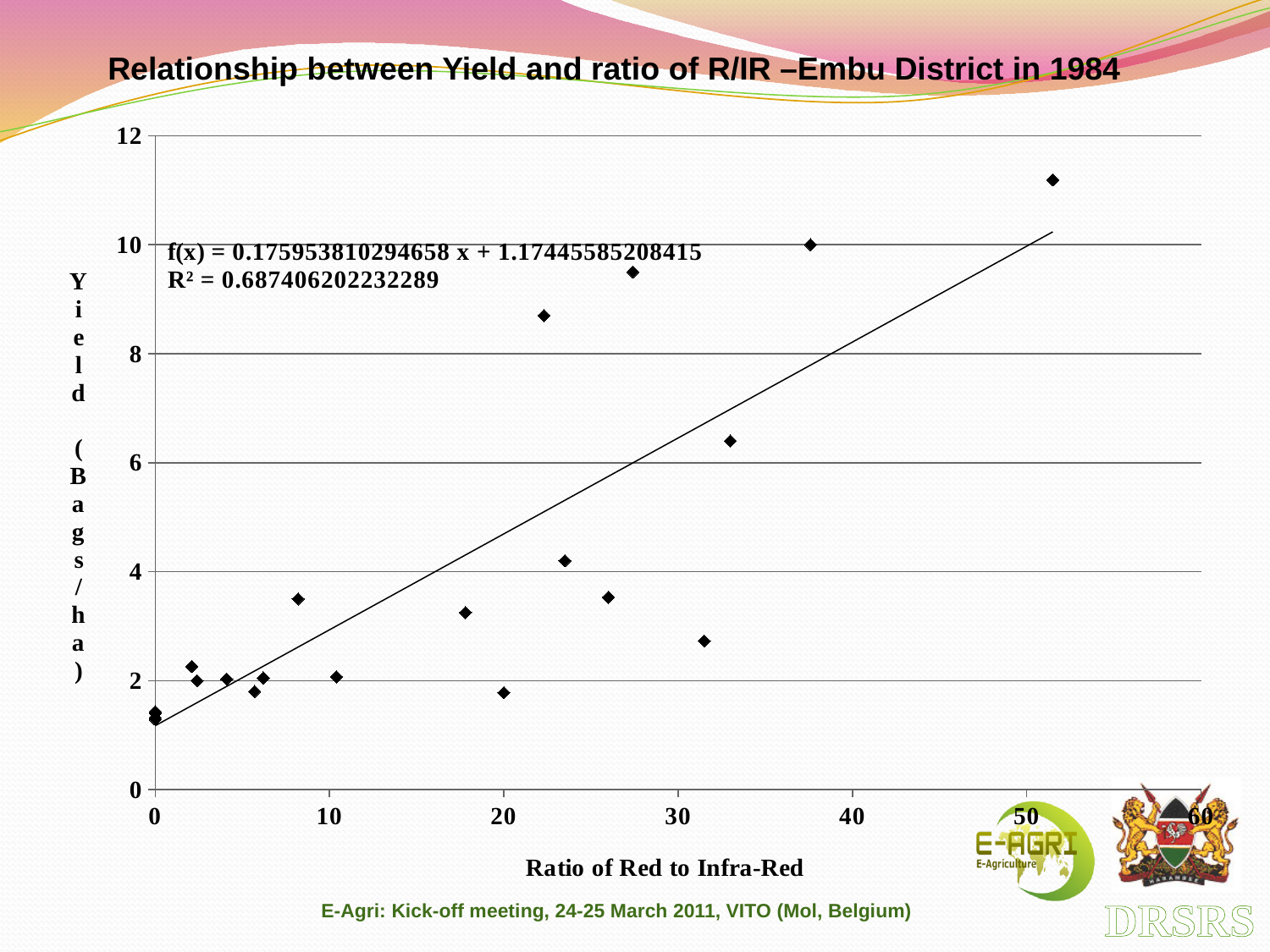
Is the yield for the point at a ratio of about 8 greater or less than 4? less Is the highest plotted yield value greater or less than 10? greater What is the title of the chart? Relationship between Yield and ratio of R/IR –Embu District in 1984 What is the title of the x axis? Ratio of Red to Infra-Red What kind of chart is shown on the slide? scatter chart Is the yield for the point at a ratio of about 33 greater or less than 6? greater What is the fitted trendline equation printed on the chart? f(x) = 0.175953810294658 x + 1.17445585208415 Which has the higher yield: the point at a ratio of about 51 or the point at a ratio of about 33? the point at a ratio of about 51 As the ratio of Red to Infra-Red increases along the x axis, does the yield generally rise or fall? rise What is the R² value printed on the chart? 0.687406202232289